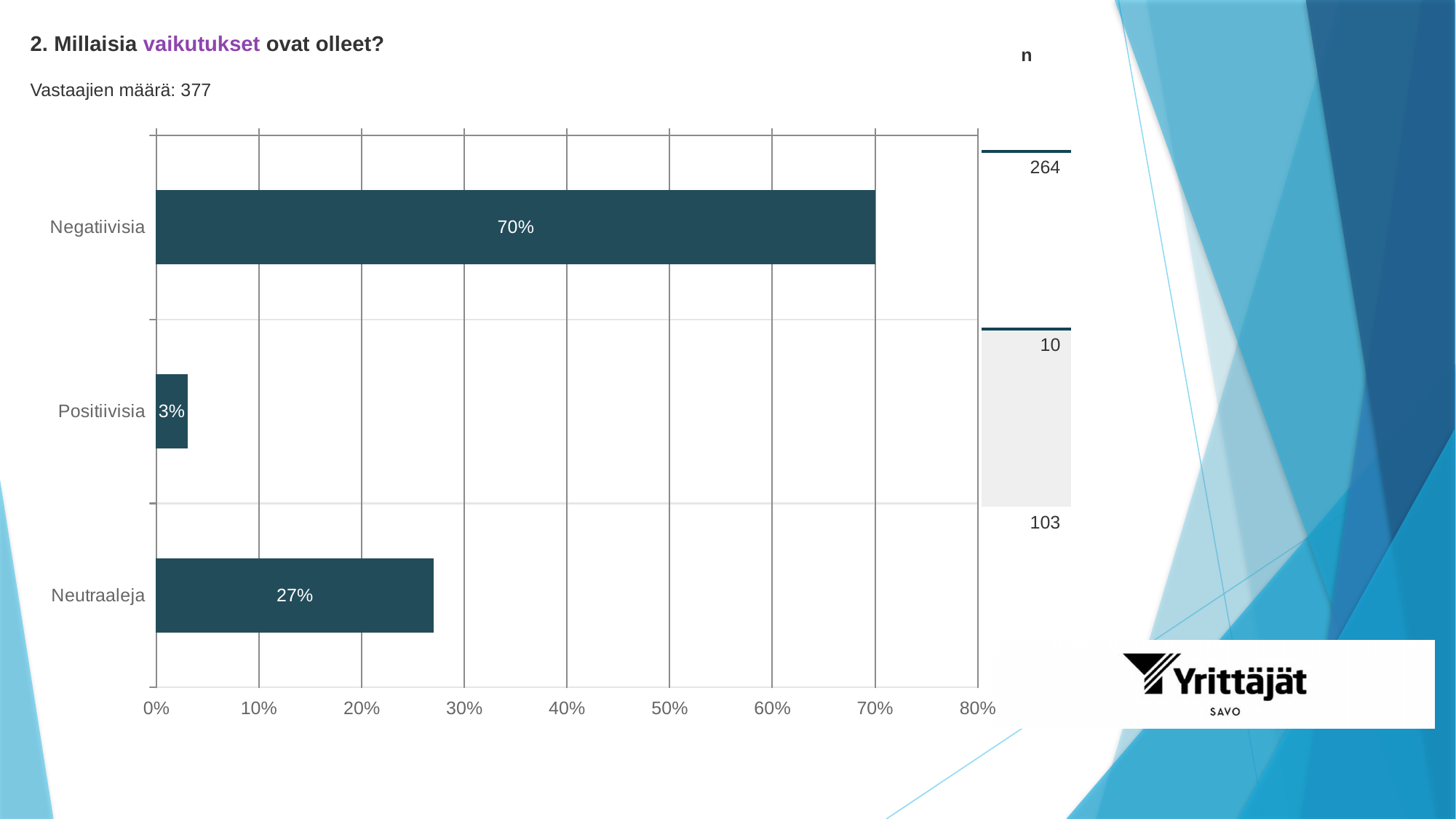
How many categories are shown in the chart? 3 What is the difference in percentage points between Negatiivisia and Neutraaleja? 43 What is the number of respondents (Vastaajien määrä) stated on the slide? 377 Which category has the lowest percentage? Positiivisia Which category has the highest percentage? Negatiivisia What kind of chart is shown on the slide? bar chart What percentage is shown for Neutraaleja? 27% What percentage is shown for Negatiivisia? 70% Which is larger, the value for Neutraaleja or the value for Positiivisia? Neutraaleja What percentage is shown for Positiivisia? 3% Is the value for Neutraaleja greater or less than 30%? less What is the n value shown for Negatiivisia? 264